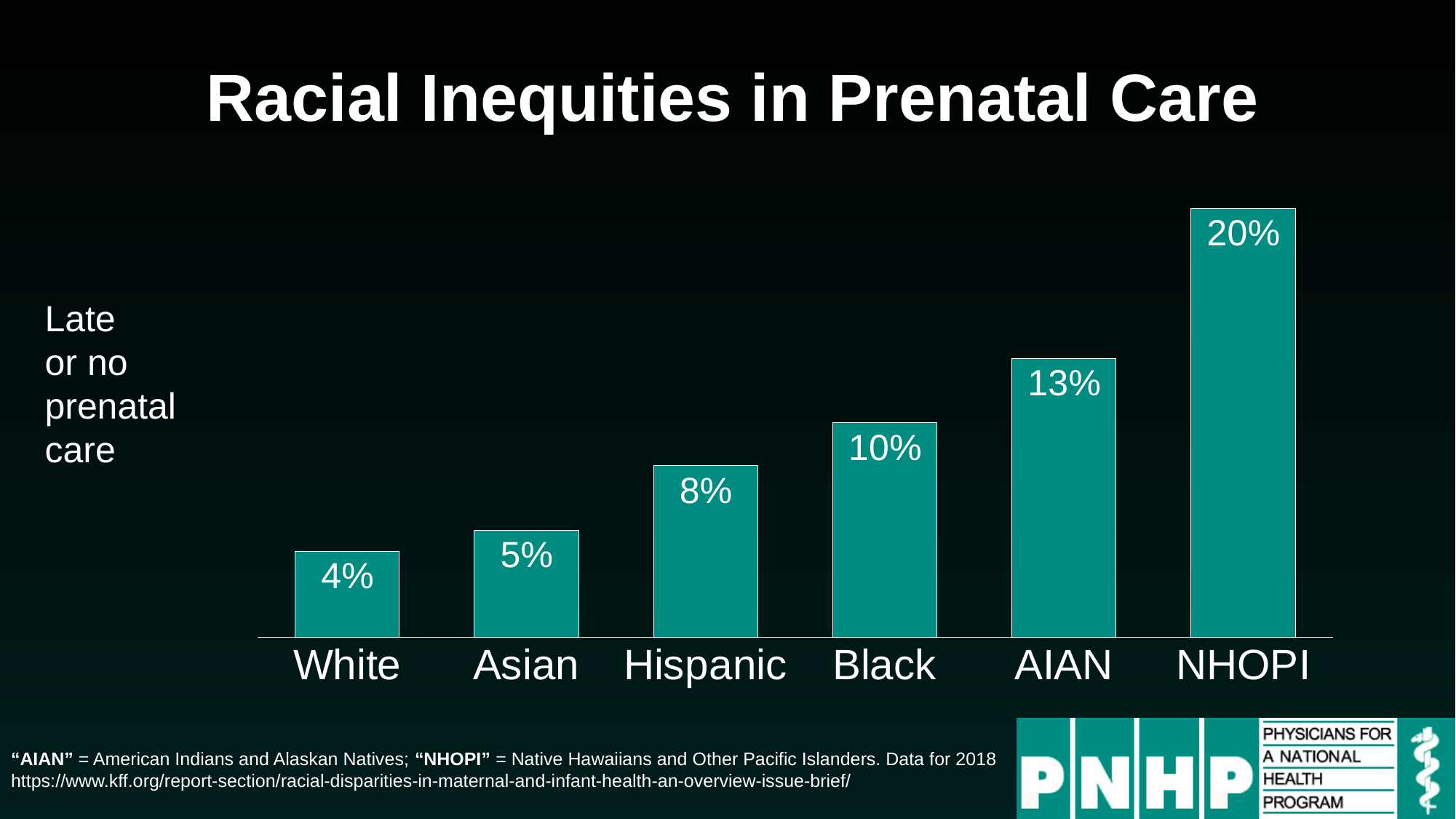
What is the value for AIAN? 13% What is the difference between the values for Asian and White? 1% What is the difference between the values for NHOPI and Black? 10% Which category has the highest value? NHOPI What is the value for Hispanic? 8% Which category has the lowest value? White What is the title of the slide containing the chart? Racial Inequities in Prenatal Care Do the values rise or fall from left to right along the x axis? Rise What kind of chart is shown on the slide? Bar chart What is the value for White? 4% Which is larger, the value for Black or the value for Hispanic? Black How many categories are shown on the chart? 6